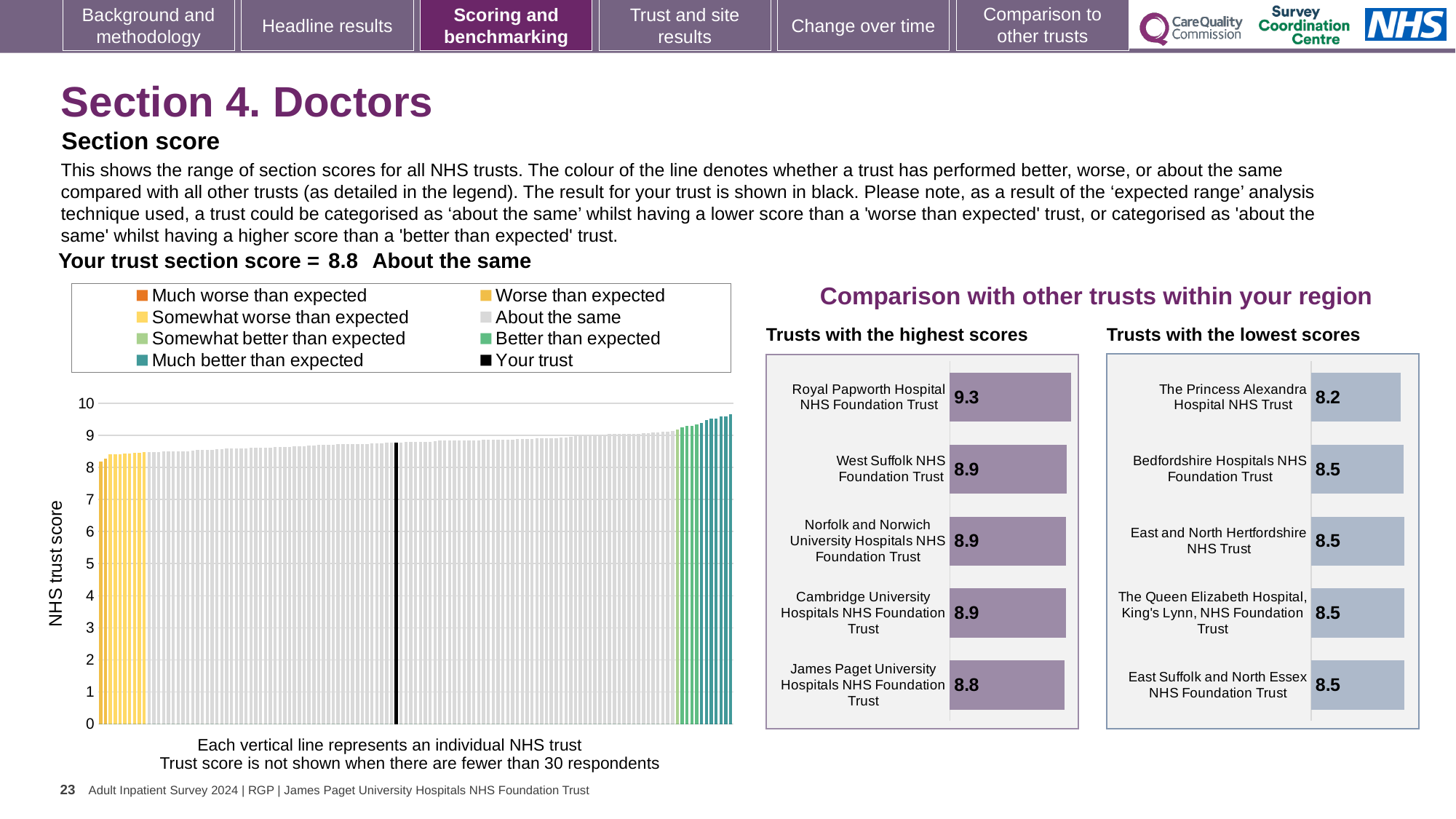
In the 'Trusts with the highest scores' chart, what is the difference between the scores of Royal Papworth Hospital NHS Foundation Trust and James Paget University Hospitals NHS Foundation Trust? 0.5 In the 'Trusts with the highest scores' chart, what is the score for Royal Papworth Hospital NHS Foundation Trust? 9.3 How many trusts are listed in the 'Trusts with the lowest scores' chart? 5 In the 'Trusts with the lowest scores' chart, which trust has the lowest score? The Princess Alexandra Hospital NHS Trust In the 'Trusts with the lowest scores' chart, what is the difference between the scores of Bedfordshire Hospitals NHS Foundation Trust and The Princess Alexandra Hospital NHS Trust? 0.3 In the 'Trusts with the highest scores' chart, what is the score for James Paget University Hospitals NHS Foundation Trust? 8.8 In the 'Trusts with the highest scores' chart, which has the larger score: Royal Papworth Hospital NHS Foundation Trust or West Suffolk NHS Foundation Trust? Royal Papworth Hospital NHS Foundation Trust In the 'Trusts with the lowest scores' chart, what is the score for The Princess Alexandra Hospital NHS Trust? 8.2 In the 'Trusts with the highest scores' chart, which trust has the highest score? Royal Papworth Hospital NHS Foundation Trust What kind of chart is the 'NHS trust score' chart on the left of the slide? Bar chart How many entries does the legend of the NHS trust score chart on the left list? 8 In the 'NHS trust score' chart on the left, do the values rise or fall from left to right? Rise